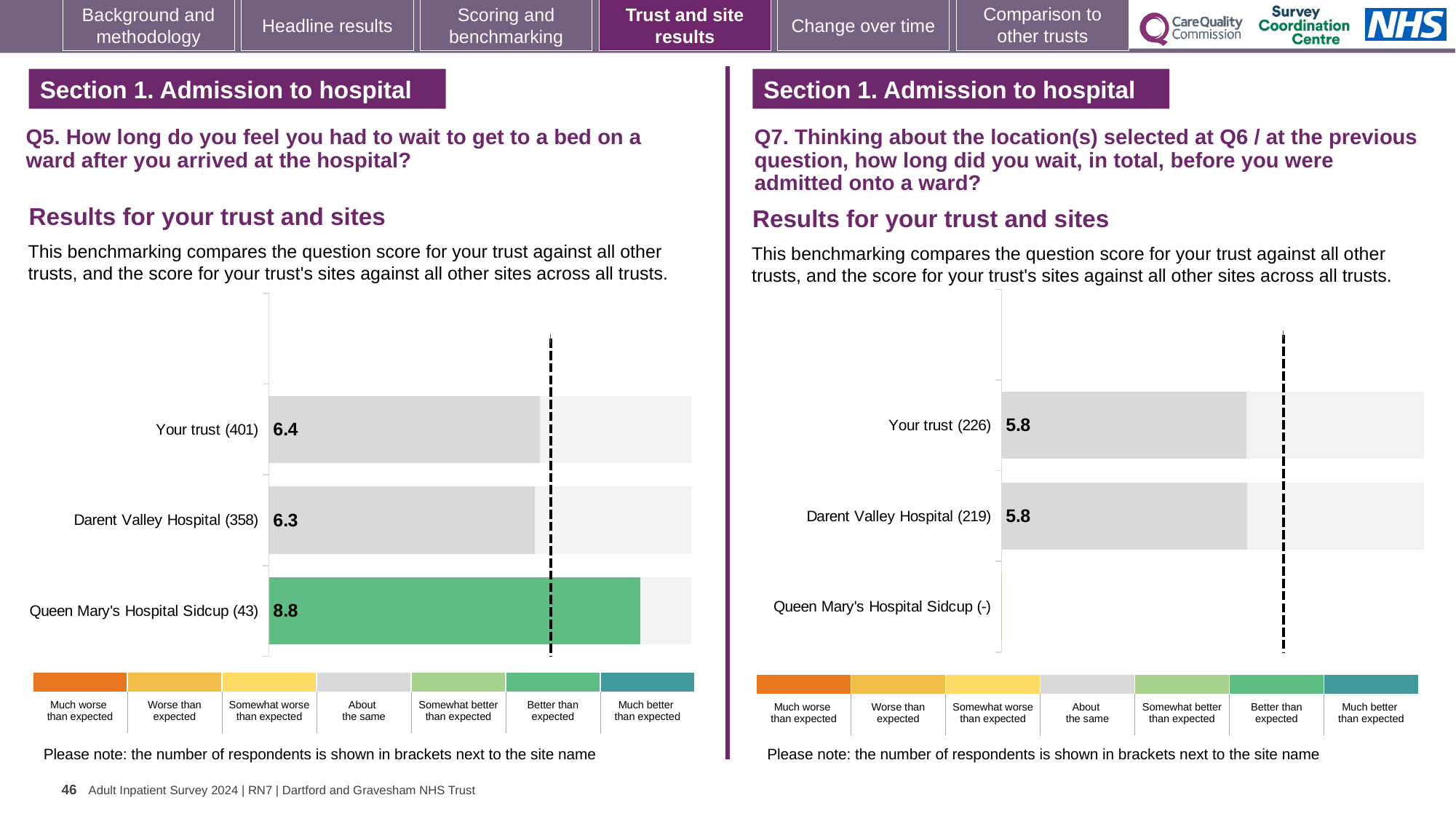
In the Q5 chart on the left, what is the score for Darent Valley Hospital (358)? 6.3 In the Q5 chart on the left, which site or trust has the highest score? Queen Mary's Hospital Sidcup (43) In the Q7 chart on the right, what is the score for Your trust (226)? 5.8 What kind of chart is used on the left for Q5? Bar chart In the Q5 chart on the left, what is the difference between the scores for Queen Mary's Hospital Sidcup and Darent Valley Hospital? 2.5 In the Q5 chart on the left, what is the score for Queen Mary's Hospital Sidcup (43)? 8.8 In the Q5 chart on the left, which bar is shown in green rather than grey? Queen Mary's Hospital Sidcup (43) In the Q7 chart on the right, what is the difference between the scores for Your trust and Darent Valley Hospital? 0 In the Q5 chart on the left, what is the score for Your trust (401)? 6.4 In the Q7 chart on the right, what is the score for Darent Valley Hospital (219)? 5.8 In the Q5 chart on the left, how many bars are plotted? 3 In the Q7 chart on the right, how many respondents are shown in brackets for Darent Valley Hospital? 219